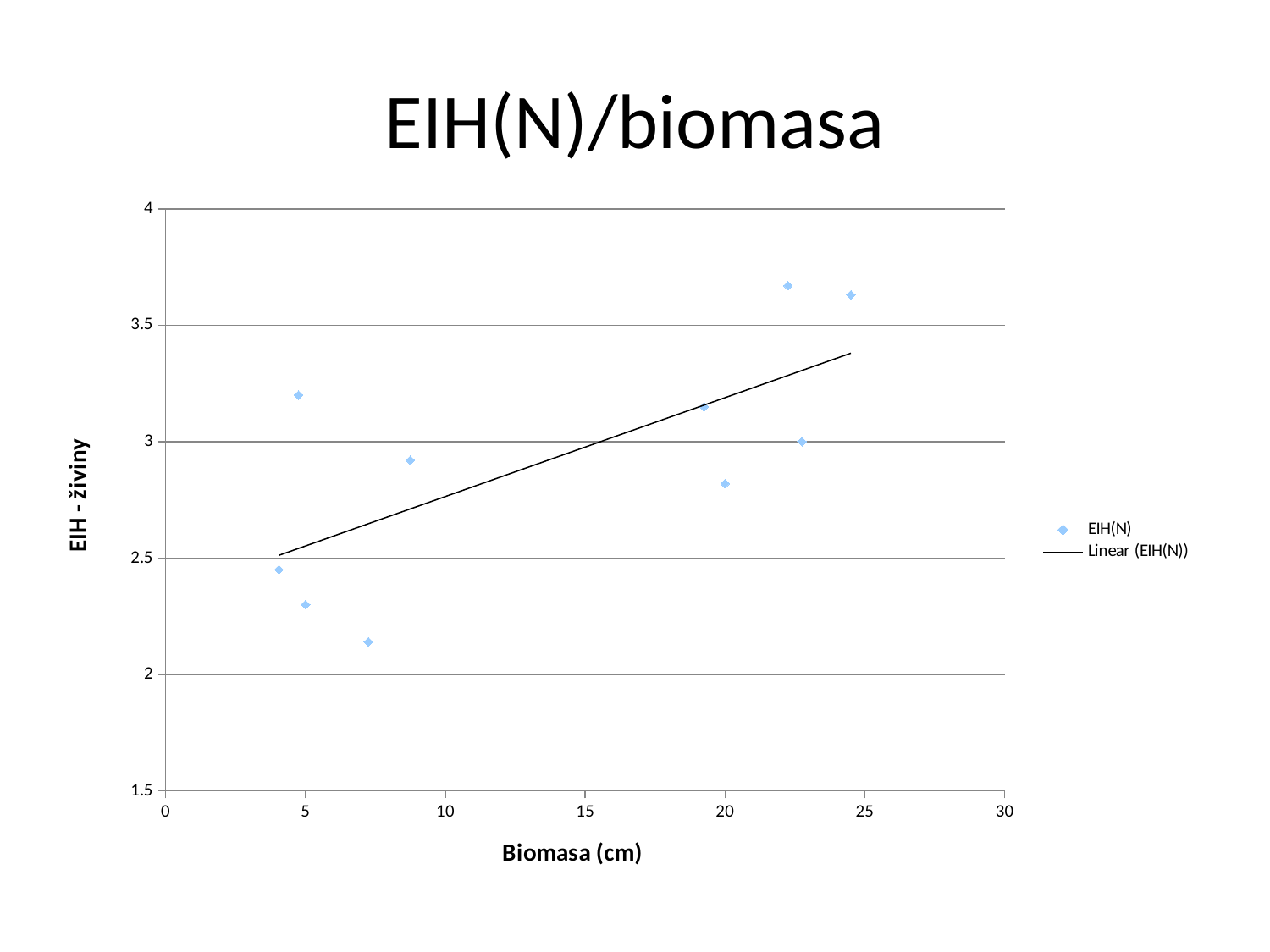
How many entries does the legend list? 2 How many data points are plotted in the EIH(N) series? 10 What is the title of the chart? EIH(N)/biomasa Is the EIH(N) value for the point at about 20 cm biomass greater or less than 3? less What is the label of the x axis? Biomasa (cm) Does the linear trendline rise or fall as biomass increases? Rises Is the EIH(N) value for the point at about 24.5 cm biomass greater or less than 3.5? greater What is the highest value shown on the y axis? 4 Is the EIH(N) value for the point at about 19 cm biomass greater or less than 3? greater What kind of chart is shown on the slide? Scatter chart